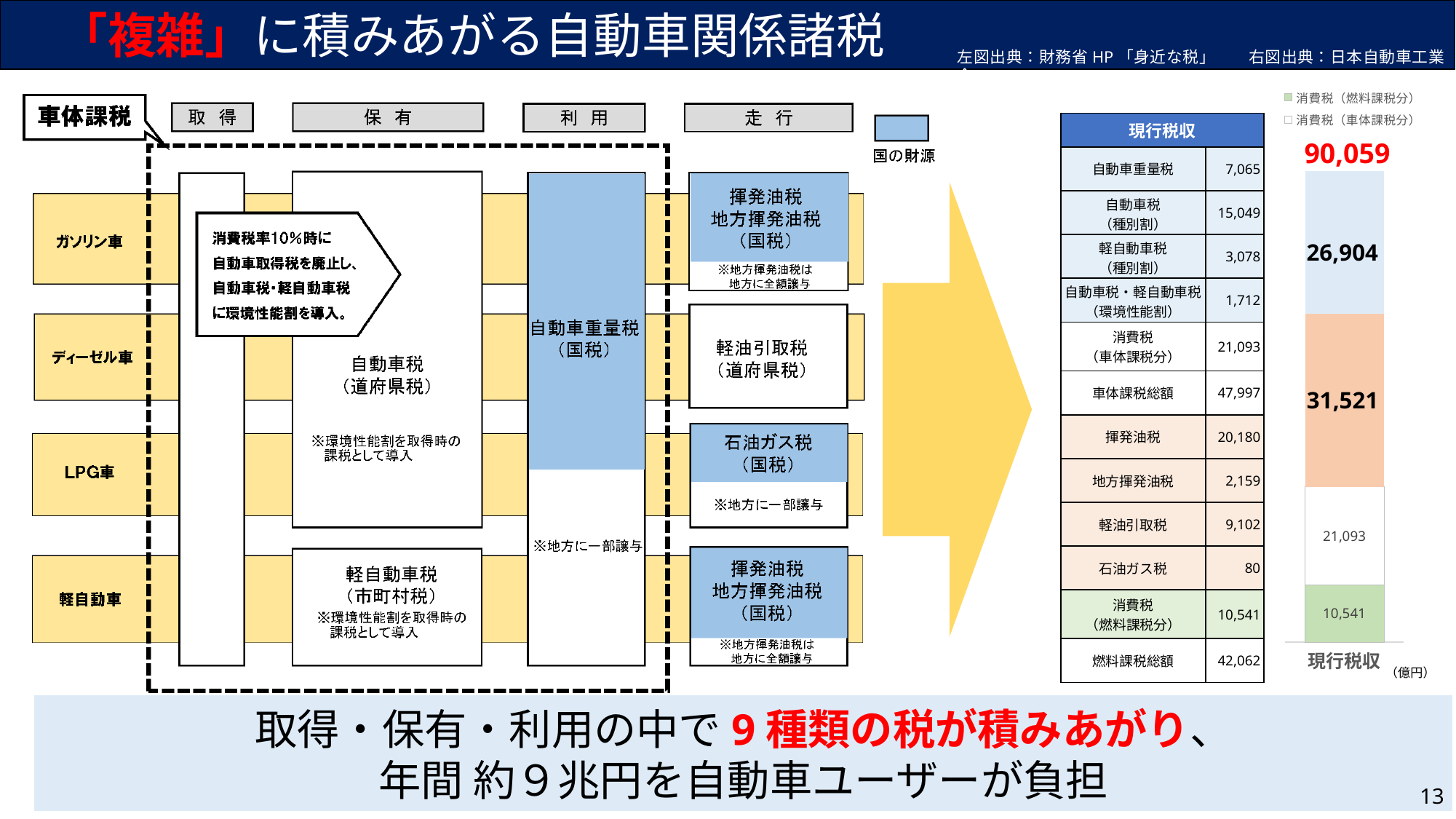
In the right-hand stacked bar chart, what is the difference between the orange segment (31,521) and the light blue segment (26,904)? 4,617 In the right-hand stacked bar chart, what is the value of the white segment? 21,093 In the right-hand stacked bar chart, what is the value of the orange segment? 31,521 Which segment of the stacked bar in the right-hand chart has the smallest value? 10,541 (green segment) What is the category label under the stacked bar in the right-hand chart? 現行税収 What type of chart is shown on the right side of the slide? Stacked bar chart In the right-hand stacked bar chart, which is larger: the white segment or the green segment? The white segment (21,093) In the right-hand stacked bar chart, what is the value of the light blue segment at the top? 26,904 In the right-hand stacked bar chart, what is the value of the green segment at the bottom? 10,541 Which segment of the stacked bar in the right-hand chart has the largest value? 31,521 (orange segment) What is the total value shown at the top of the stacked bar in the right-hand chart? 90,059 How many segments make up the stacked bar in the right-hand chart? 4